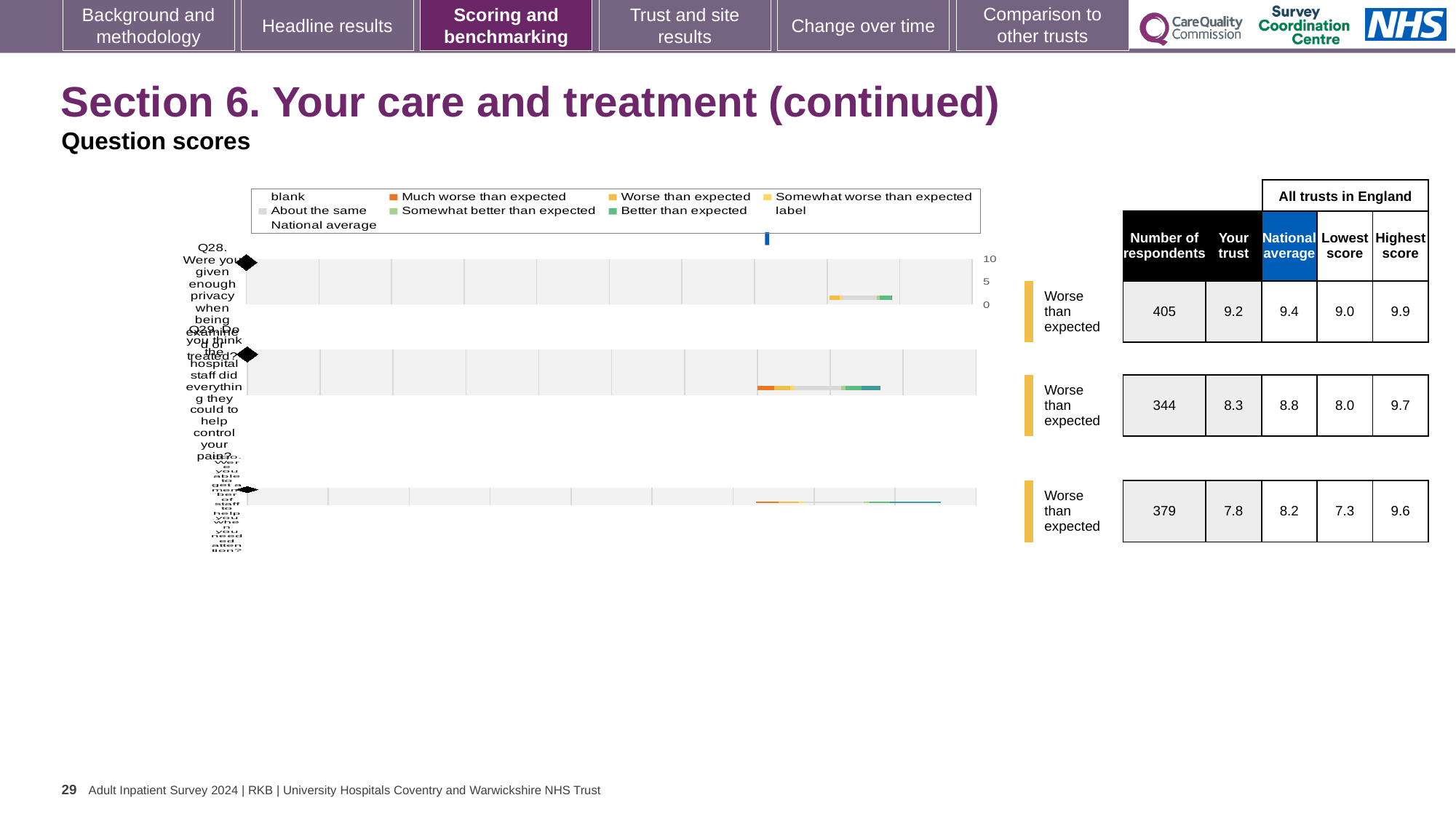
What kind of chart is used to show the question scores on this slide? bar chart For Q29 (hospital staff did everything to help control your pain), what is the number of respondents? 344 For the bottom chart (third question), what is the lowest score among all trusts in England? 7.3 For Q28 (privacy when being examined or treated), what is the 'Your trust' score? 9.2 Which of the three questions has the highest 'Your trust' score? Q28 For the bottom chart (third question), what is the 'Your trust' score? 7.8 What benchmark label is shown next to the Q28 chart? Worse than expected How many question charts are shown on the slide? 3 Is the 'Your trust' score for Q29 larger or smaller than the 'Your trust' score for the bottom chart (third question)? larger For Q28 (privacy when being examined or treated), what is the national average score? 9.4 What is the difference between the national average and the 'Your trust' score for Q28? 0.2 For Q29 (hospital staff did everything to help control your pain), what is the highest score among all trusts in England? 9.7